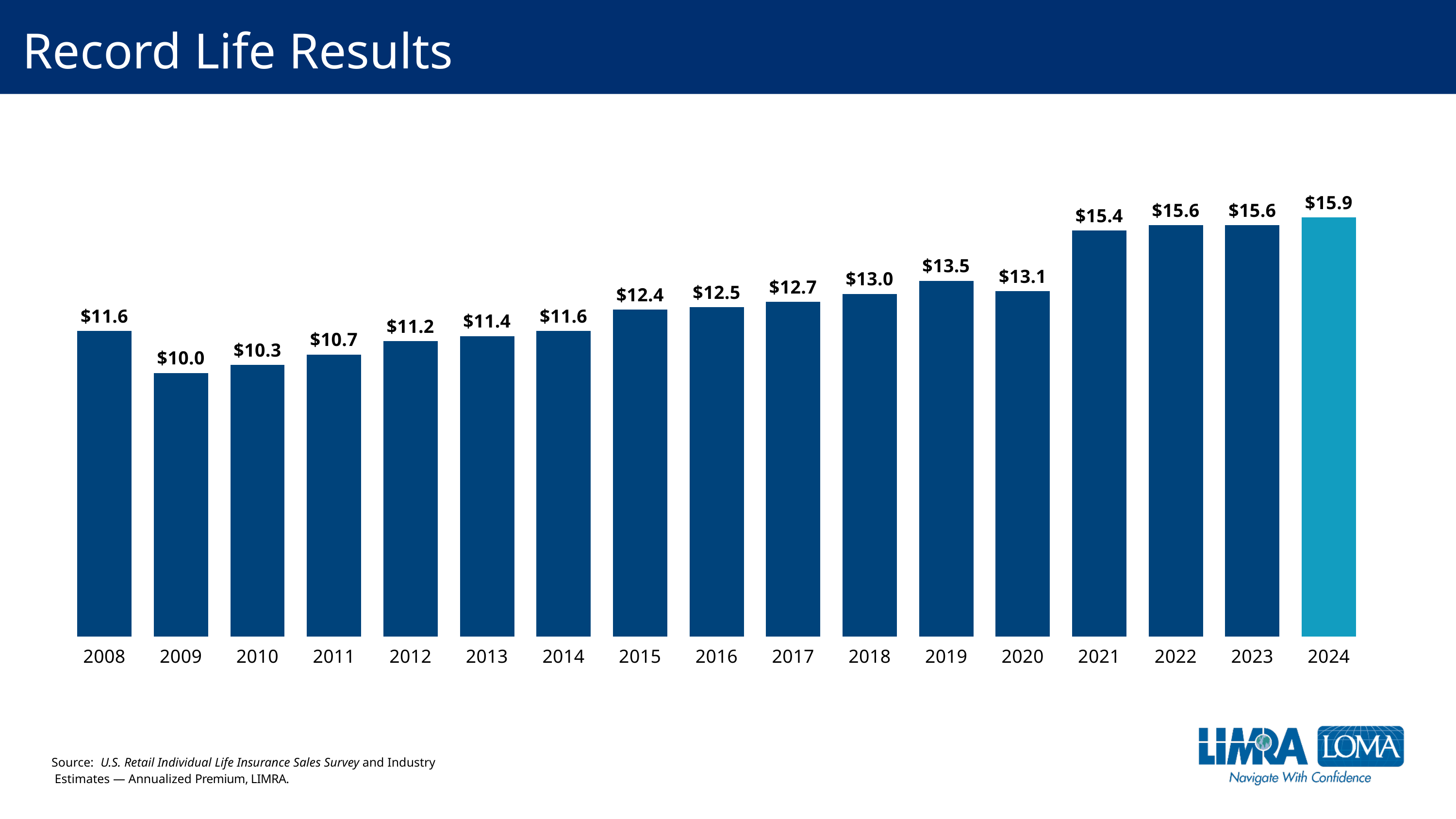
Which year has the lowest value? 2009 What is the value shown for 2024? $15.9 How many years are shown on the x axis? 17 Which year has the highest value? 2024 What is the value shown for 2009? $10.0 What is the difference between the values for 2024 and 2008? $4.3 What kind of chart is shown on the slide? Bar chart What is the difference between the values for 2020 and 2019? $0.4 Which is larger, the value for 2020 or the value for 2021? 2021 What is the value shown for 2019? $13.5 Do the values generally rise or fall from 2009 to 2024? Rise Which bar is shown in a different, lighter colour from the others? 2024